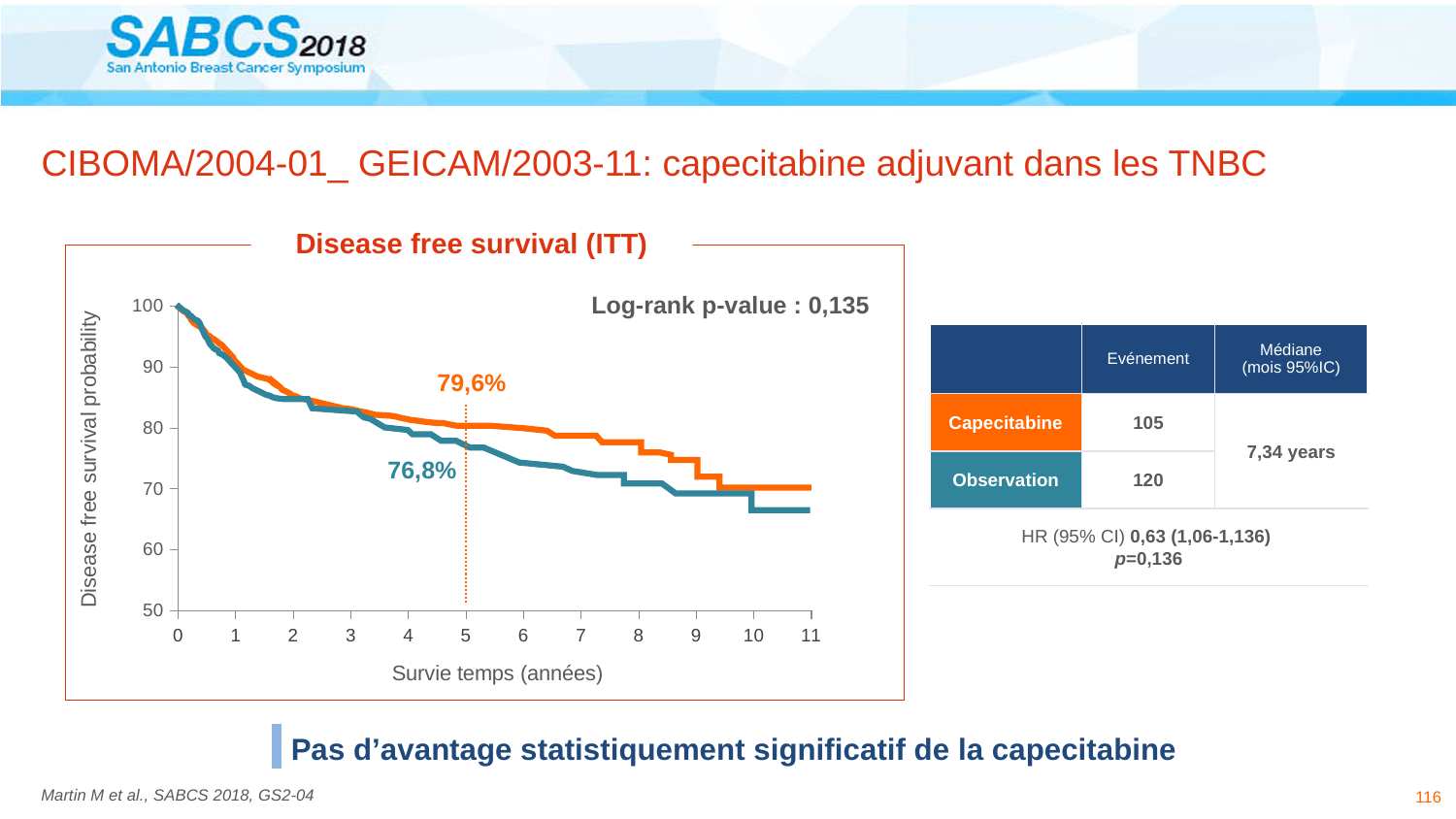
What is the label of the x axis of the chart? Survie temps (années) What is the lowest value shown on the y axis of the chart? 50 How many survival curves are plotted on the chart? 2 What is the disease free survival probability labelled for the capecitabine (orange) curve at 5 years? 79,6% At 5 years, which curve has the higher labelled disease free survival probability, capecitabine or observation? Capecitabine Is the value of the capecitabine (orange) curve at 8 years greater or less than 70? greater What is the difference between the labelled 5-year values of the capecitabine and observation curves? 2,8 percentage points Is the value of the observation (teal) curve at 10 years greater or less than 70? less Do the survival curves rise or fall as time along the x axis increases? Fall What is the disease free survival probability labelled for the observation (teal) curve at 5 years? 76,8% What log-rank p-value is printed on the chart? 0,135 What kind of chart is shown under the title 'Disease free survival (ITT)'? Line chart (Kaplan-Meier survival curve)